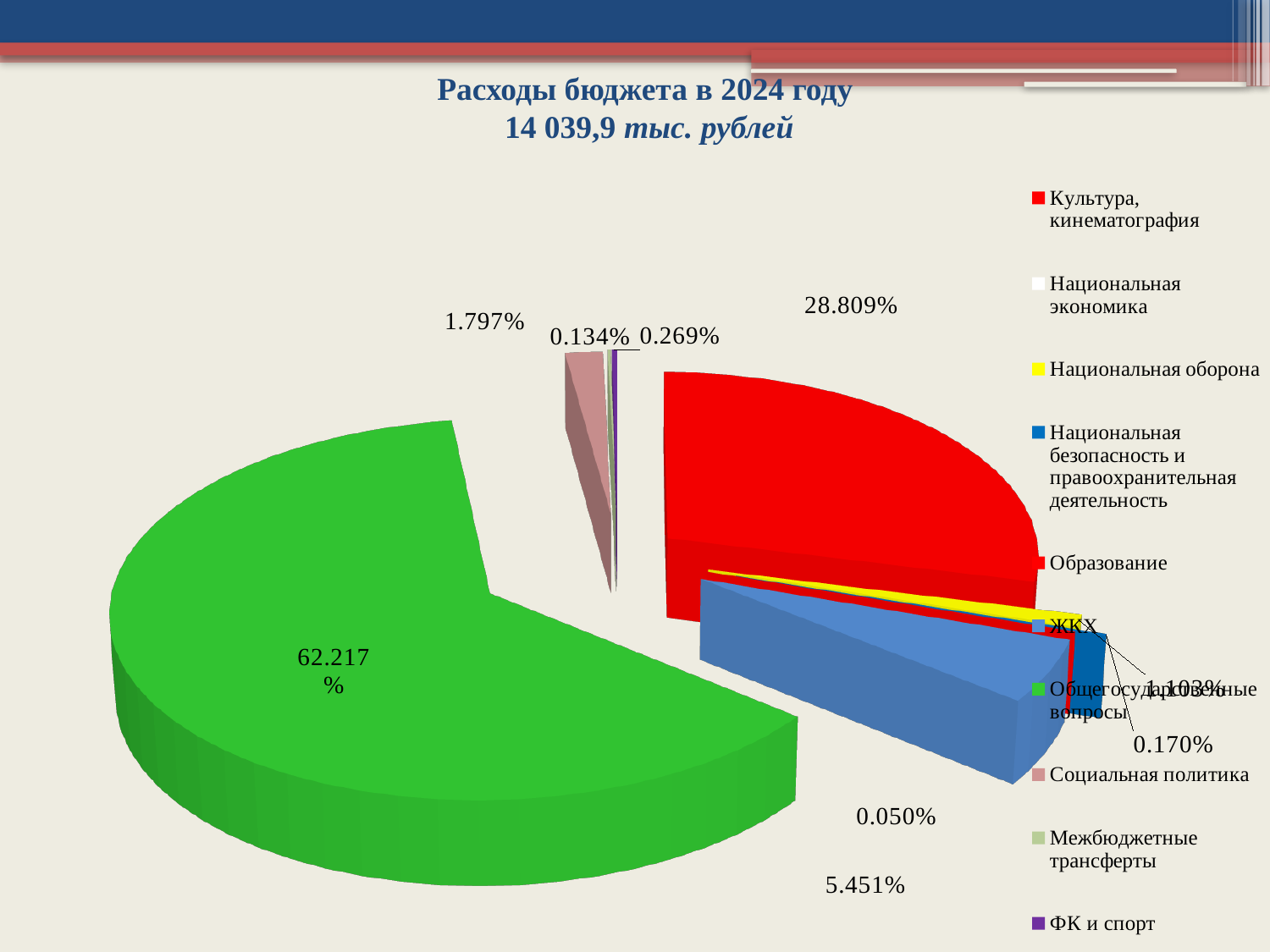
What is the smallest percentage labelled on the pie chart? 0.050% What share of the pie does ЖКХ take? 5.451% What colour is the slice for Общегосударственные вопросы? green Which slice is larger: Культура, кинематография or ЖКХ? Культура, кинематография What is the title of the chart? Расходы бюджета в 2024 году 14 039,9 тыс. рублей What share of the pie does Культура, кинематография take? 28.809% What is the difference in percentage points between Общегосударственные вопросы and Культура, кинематография? 33.408% What share of the pie does Общегосударственные вопросы take? 62.217% What kind of chart is shown on the slide? pie chart Which category has the largest slice of the pie? Общегосударственные вопросы How many categories does the legend list? 10